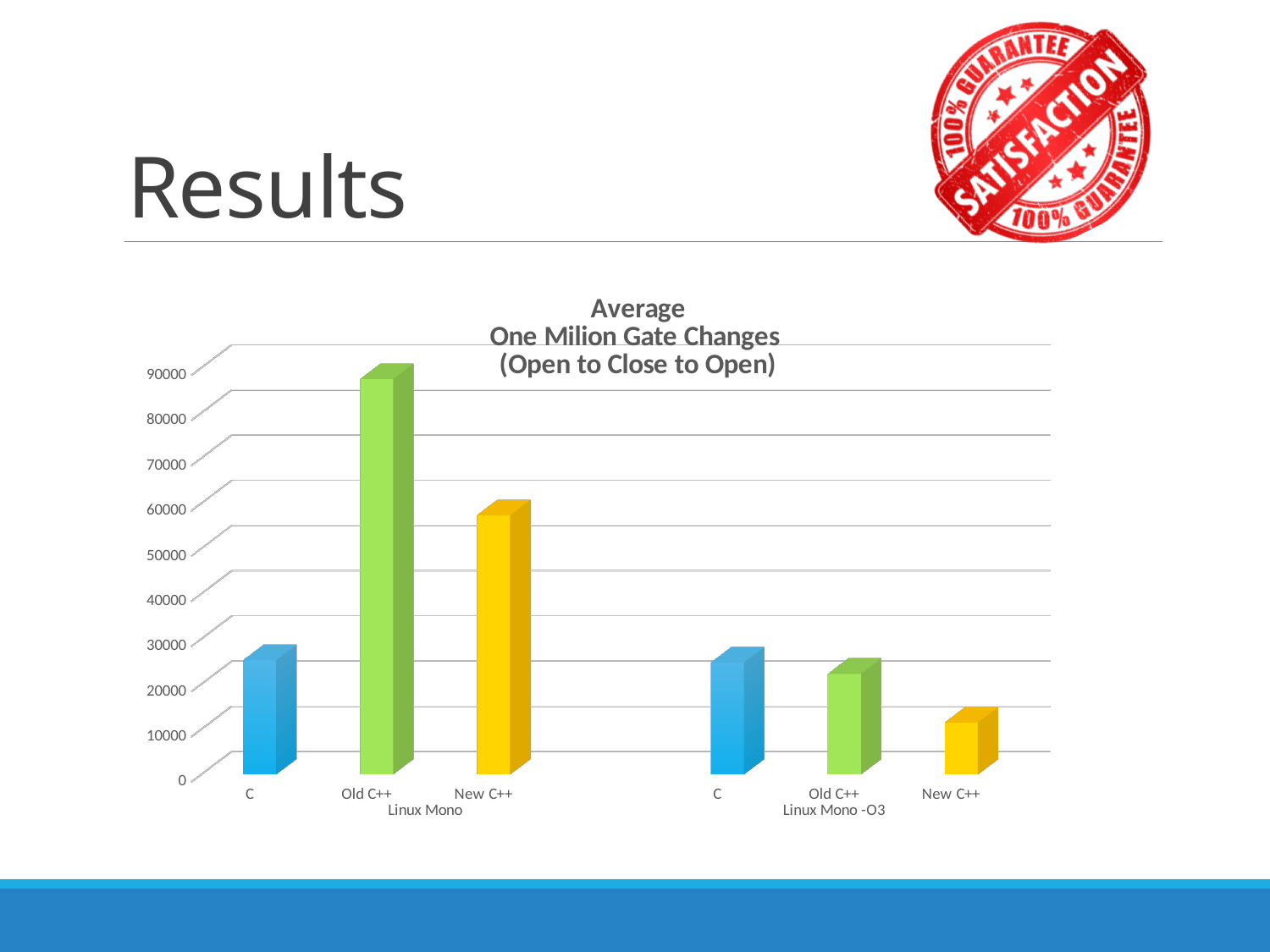
What kind of chart is shown on the slide? bar chart Which bar has the highest value in the chart? Old C++ under Linux Mono Which bar has the lowest value in the chart? New C++ under Linux Mono -O3 Is the value for New C++ under Linux Mono greater or less than 50000? greater Is the value for New C++ under Linux Mono -O3 greater or less than 20000? less Is the value for C under Linux Mono greater or less than 20000? greater What is the title of the chart? Average One Milion Gate Changes (Open to Close to Open) Which is larger: Old C++ under Linux Mono or Old C++ under Linux Mono -O3? Old C++ under Linux Mono How many bars are plotted in the chart? 6 What are the two group labels shown along the x axis? Linux Mono and Linux Mono -O3